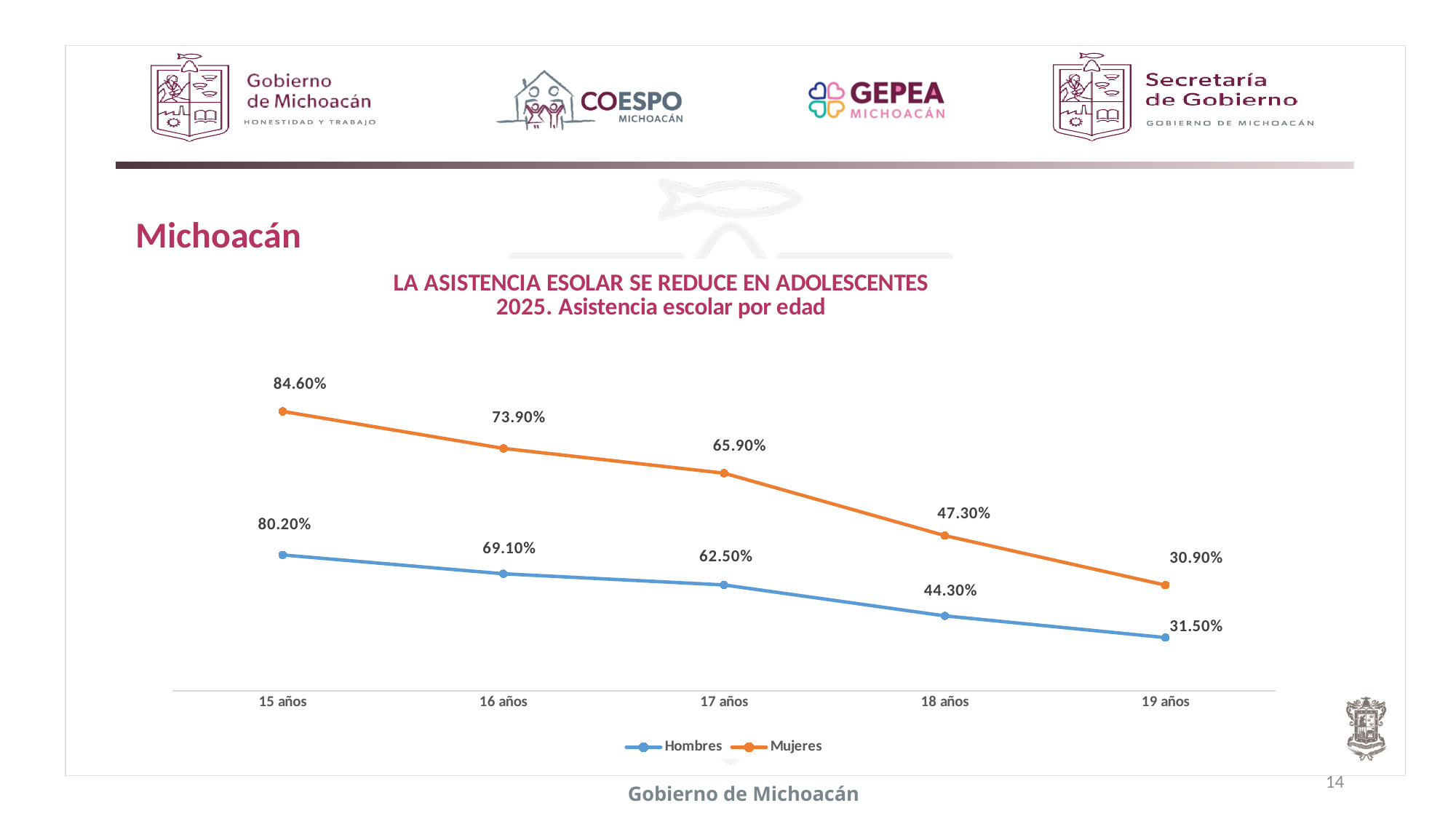
How many age categories are shown on the x axis? 5 What is the value for Hombres at 19 años? 31.50% What is the school attendance value for Hombres at 17 años? 62.50% How many series does the legend list? 2 At which age is the Hombres series highest? 15 años At which age is the Mujeres series lowest? 19 años What is the school attendance value for Mujeres at 15 años? 84.60% What is the difference between Mujeres and Hombres at 16 años? 4.80% Which series has the larger value at 17 años, Hombres or Mujeres? Mujeres What is the value for Mujeres at 18 años? 47.30% Do the values for Mujeres rise or fall as age increases from 15 años to 19 años? Fall What type of chart is shown on the slide? Line chart